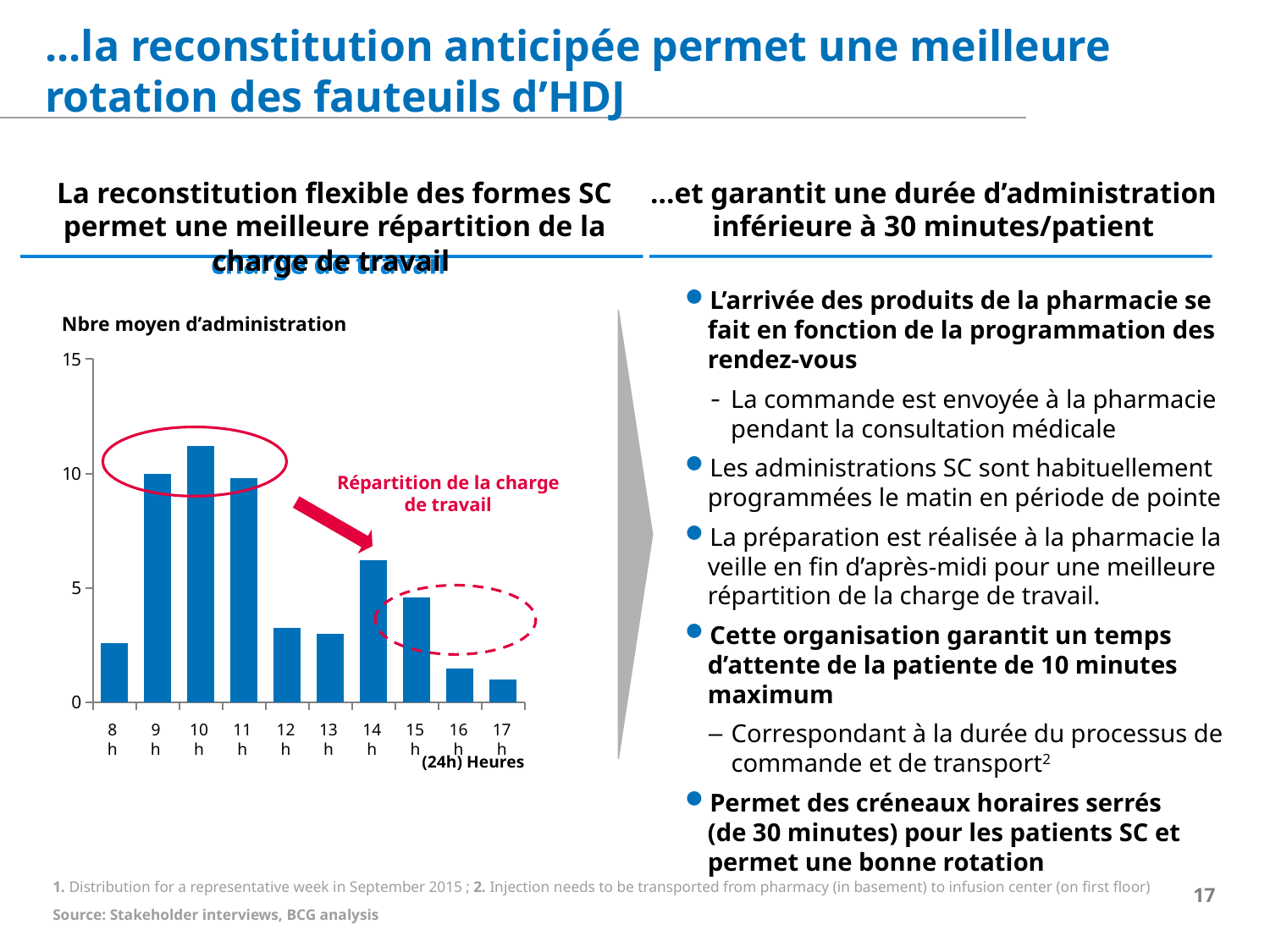
At which hour is the average number of administrations lowest? 17 h Do the values rise or fall from 14 h to 17 h? fall What kind of chart is shown on the slide? bar chart How many hourly categories are plotted on the x axis of the chart? 10 Is the value for 14 h greater or less than 5? greater Is the value for 16 h greater or less than 5? less What is the title shown above the chart? Nbre moyen d'administration At which hour is the average number of administrations highest? 10 h Which has the larger value, 10 h or 11 h? 10 h Which has the larger value, 14 h or 15 h? 14 h Is the value for 10 h greater or less than 10? greater